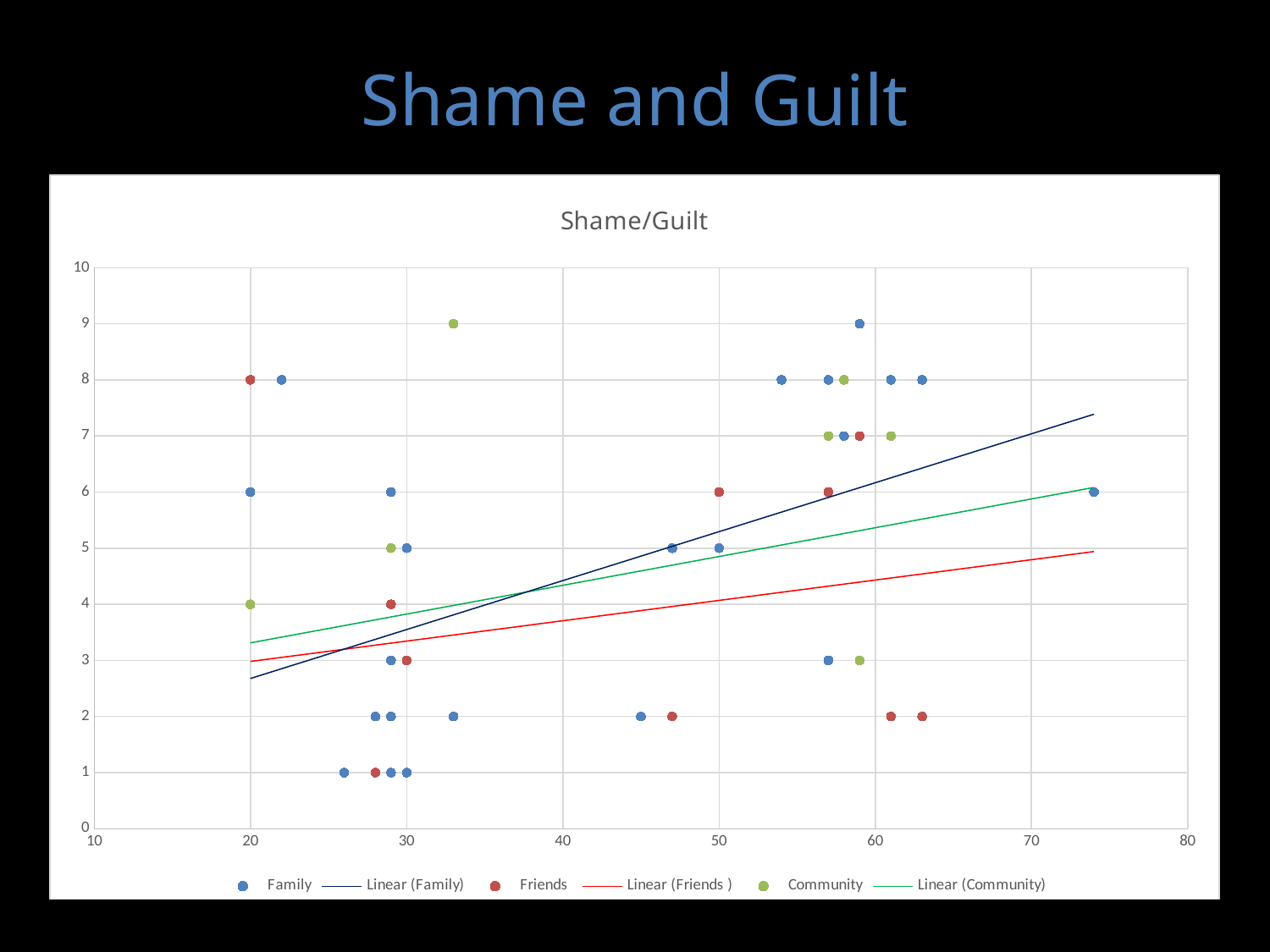
How many entries does the chart legend list? 6 What is the lowest y value reached by any Friends point? 1 How many series of data points (excluding trendlines) are plotted on the chart? 3 Is the value of the Linear (Family) trendline at x = 70 greater or less than 6? greater What is the title of the chart? Shame/Guilt What is the highest y value reached by any Community point? 9 What is the highest y value reached by any Family point? 9 What is the highest y value reached by any Friends point? 8 Which colour is used for the Friends data points? red Do the linear trendlines rise or fall as the x value increases? rise What kind of chart is shown on the slide? scatter chart